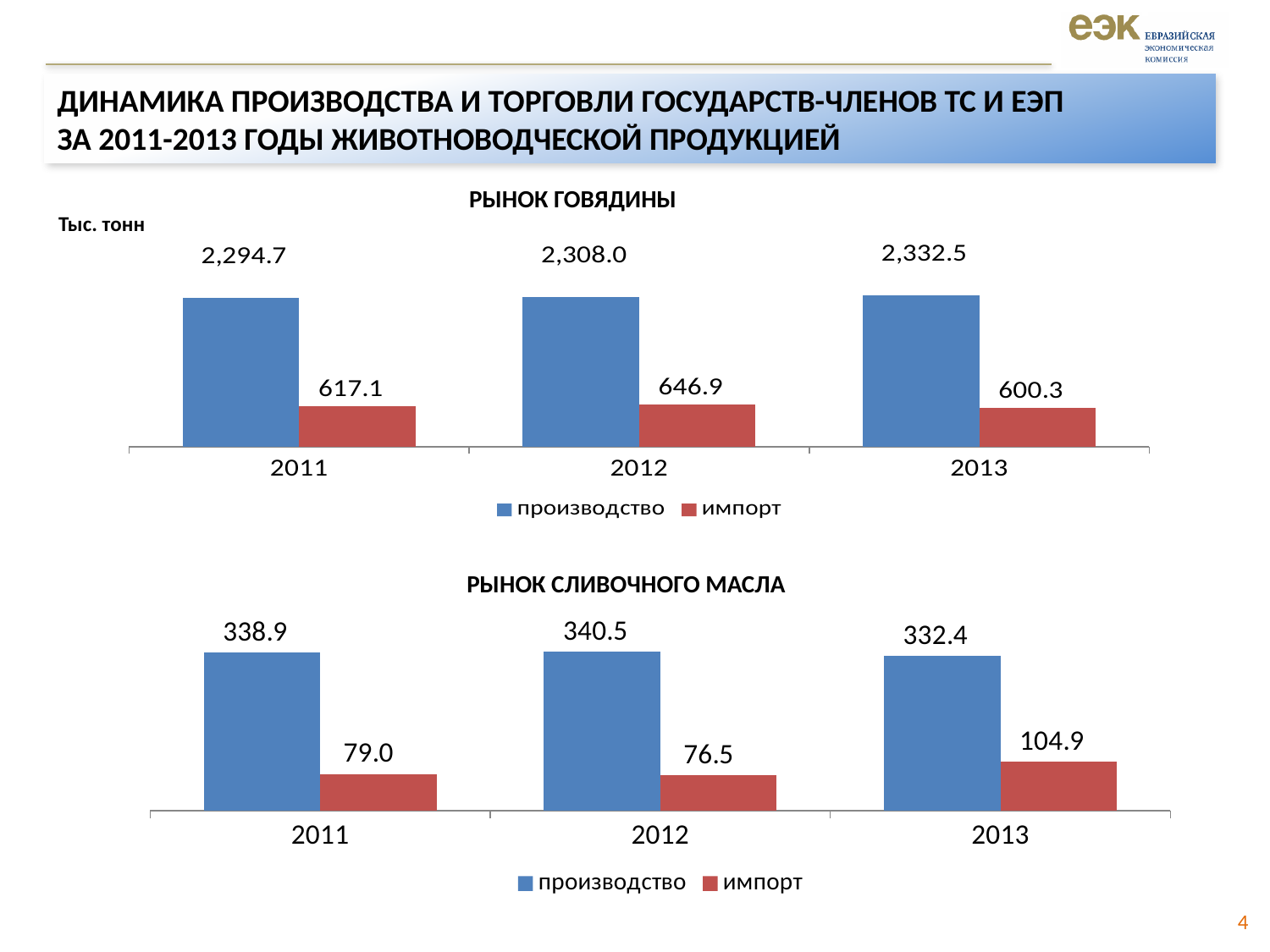
In the 'РЫНОК СЛИВОЧНОГО МАСЛА' chart, what is the value for производство in 2011? 338.9 In the 'РЫНОК ГОВЯДИНЫ' chart, does производство rise or fall from 2011 to 2013? rise In the 'РЫНОК ГОВЯДИНЫ' chart, which year has the highest импорт value? 2012 In the 'РЫНОК СЛИВОЧНОГО МАСЛА' chart, which year has the highest производство value? 2012 In the 'РЫНОК ГОВЯДИНЫ' chart, what is the value for производство in 2012? 2,308.0 In the 'РЫНОК СЛИВОЧНОГО МАСЛА' chart, what is the value for импорт in 2013? 104.9 How many series does the legend of the 'РЫНОК ГОВЯДИНЫ' chart list? 2 In the 'РЫНОК ГОВЯДИНЫ' chart, what is the value for импорт in 2013? 600.3 In the 'РЫНОК СЛИВОЧНОГО МАСЛА' chart, what is the difference in импорт between 2013 and 2012? 28.4 In the 'РЫНОК ГОВЯДИНЫ' chart, what is the difference between производство and импорт in 2011? 1,677.6 In the 'РЫНОК СЛИВОЧНОГО МАСЛА' chart, which year has the lowest импорт value? 2012 What type of chart is the 'РЫНОК СЛИВОЧНОГО МАСЛА' chart? bar chart